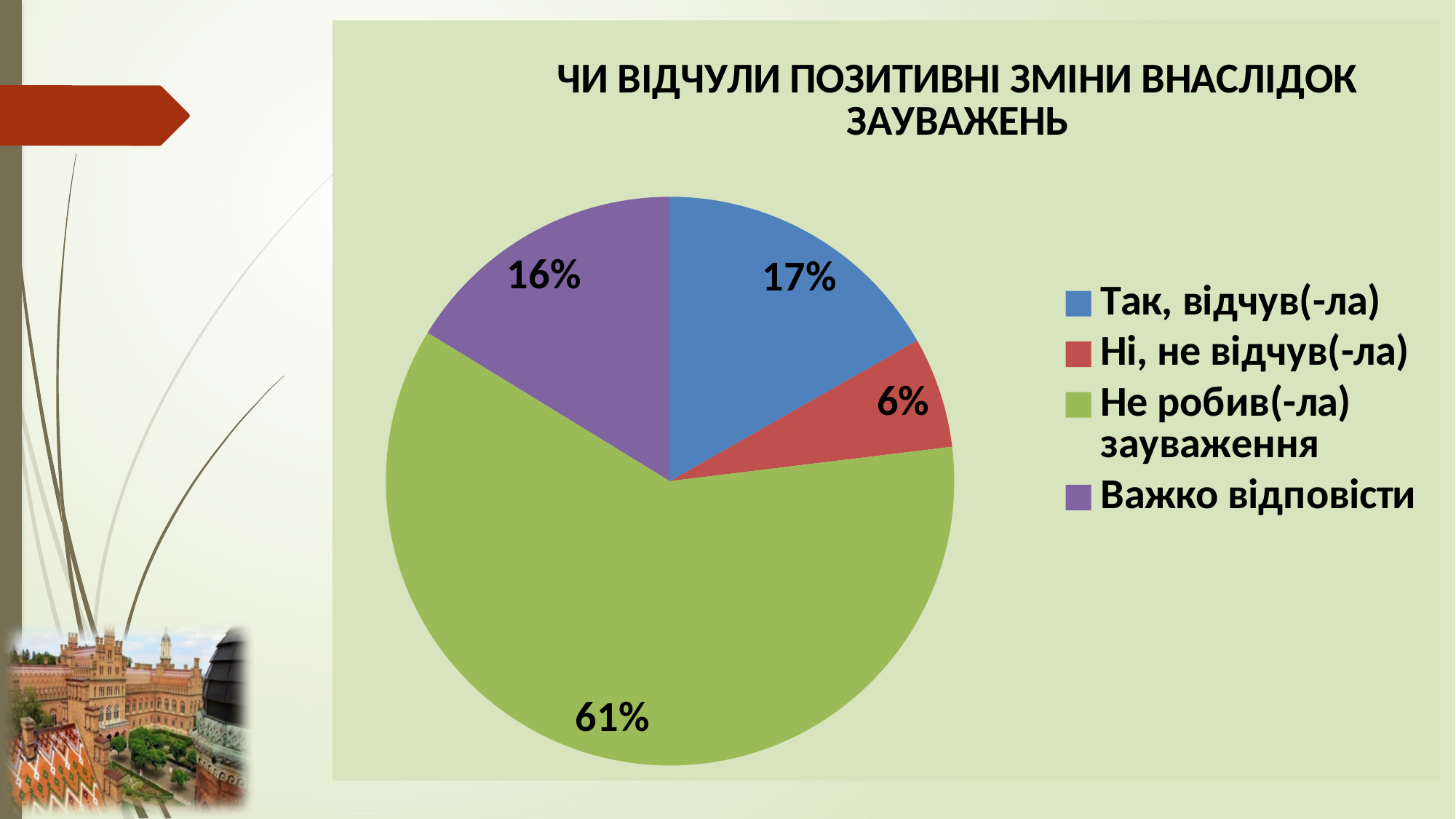
What kind of chart is shown on the slide? pie chart What is the difference in percentage points between "Не робив(-ла) зауваження" and "Так, відчув(-ла)"? 44 Which is larger: the slice for "Так, відчув(-ла)" or the slice for "Ні, не відчув(-ла)"? Так, відчув(-ла) Which category has the largest slice of the pie? Не робив(-ла) зауваження What is the title of the chart? ЧИ ВІДЧУЛИ ПОЗИТИВНІ ЗМІНИ ВНАСЛІДОК ЗАУВАЖЕНЬ What share of the pie is labelled "Важко відповісти"? 16% What share of the pie is labelled "Так, відчув(-ла)"? 17% Which category has the smallest slice of the pie? Ні, не відчув(-ла) How many slices does the pie chart have? 4 What share of the pie is labelled "Ні, не відчув(-ла)"? 6% What share of the pie is labelled "Не робив(-ла) зауваження"? 61% What colour is the slice for "Важко відповісти"? purple